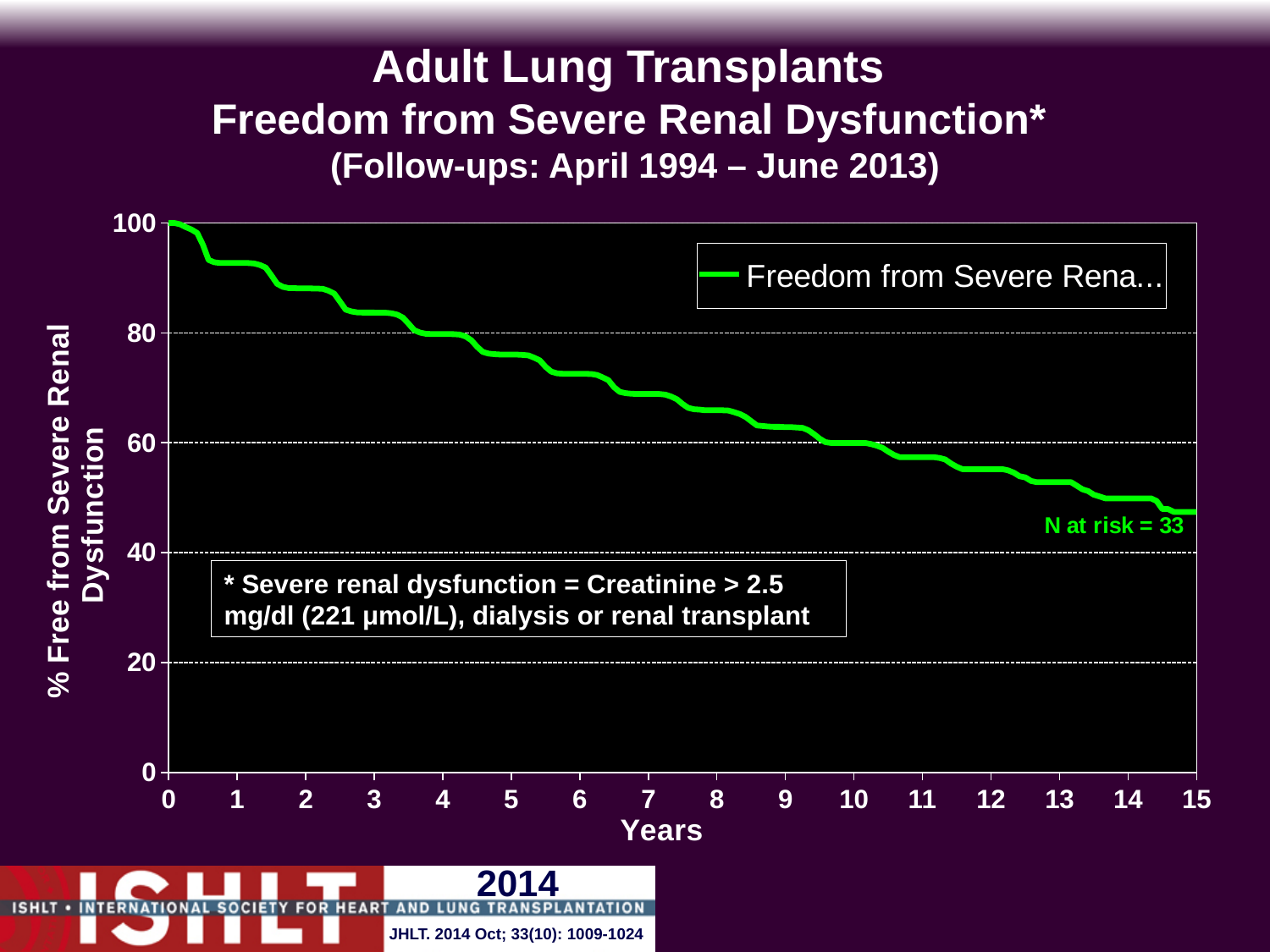
What is the highest year shown on the x axis? 15 Is the value of the curve at year 1 greater or less than 80? greater What is the N at risk stated on the chart? 33 What is the label of the x axis? Years Is the value of the curve at year 5 greater or less than 80? less Does the percentage free from severe renal dysfunction rise or fall as the years increase? fall What is the value of the curve at year 0? 100 How many series does the legend list? 1 Is the value of the curve at year 12 greater or less than 60? less What kind of chart is shown on the slide? line chart